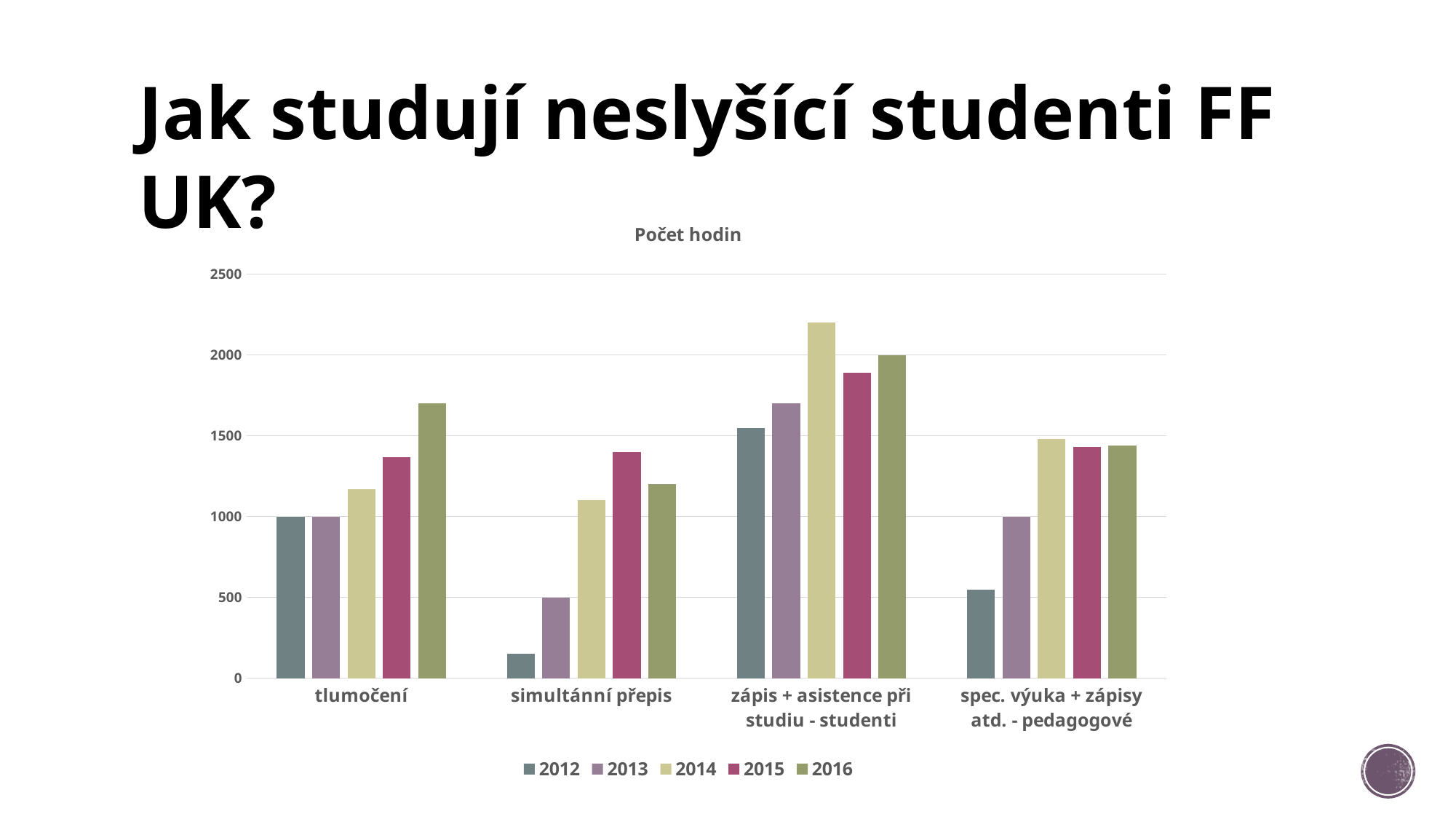
What is the title of the chart? Počet hodin What is the value for 2016 in the zápis + asistence při studiu - studenti category? 2000 Which year has the lowest value in the simultánní přepis category? 2012 Is the value for 2012 in the spec. výuka + zápisy atd. - pedagogové category greater or less than 1000? less Which year has the highest value in the zápis + asistence při studiu - studenti category? 2014 What is the value for 2012 in the tlumočení category? 1000 What is the value for 2013 in the simultánní přepis category? 500 How many series does the legend list? 5 In the tlumočení category, which is larger: the value for 2015 or the value for 2016? 2016 How many categories are shown on the x axis? 4 What type of chart is shown on the slide? bar chart Is the value for 2016 in the tlumočení category greater or less than 1500? greater